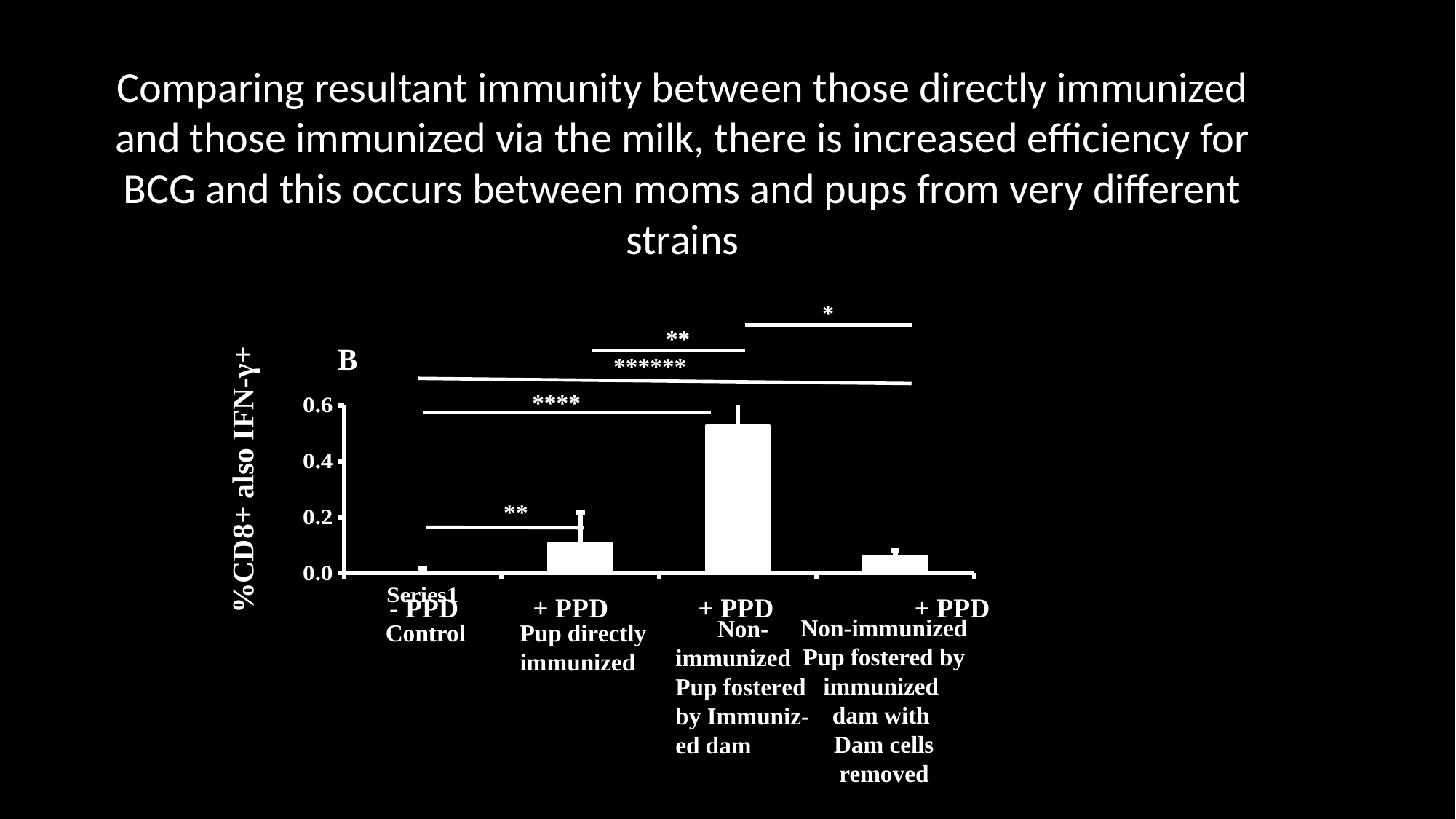
Is the value for Non-immunized Pup fostered by immunized dam with Dam cells removed greater or less than 0.2? less Is the value for Pup directly immunized greater or less than 0.2? less What is the highest tick value shown on the y axis? 0.6 Is the value for Non-immunized Pup fostered by Immunized dam greater or less than 0.4? greater Which category has the lowest value in the chart? Control How many bars are plotted in the chart? 4 What is the label on the y axis of the chart? %CD8+ also IFN-γ+ Which is larger: the value for Pup directly immunized or the value for Non-immunized Pup fostered by Immunized dam? Non-immunized Pup fostered by Immunized dam Which category has the highest value in the chart? Non-immunized Pup fostered by Immunized dam What kind of chart is shown on the slide? bar chart Which is larger: the value for Control or the value for Pup directly immunized? Pup directly immunized